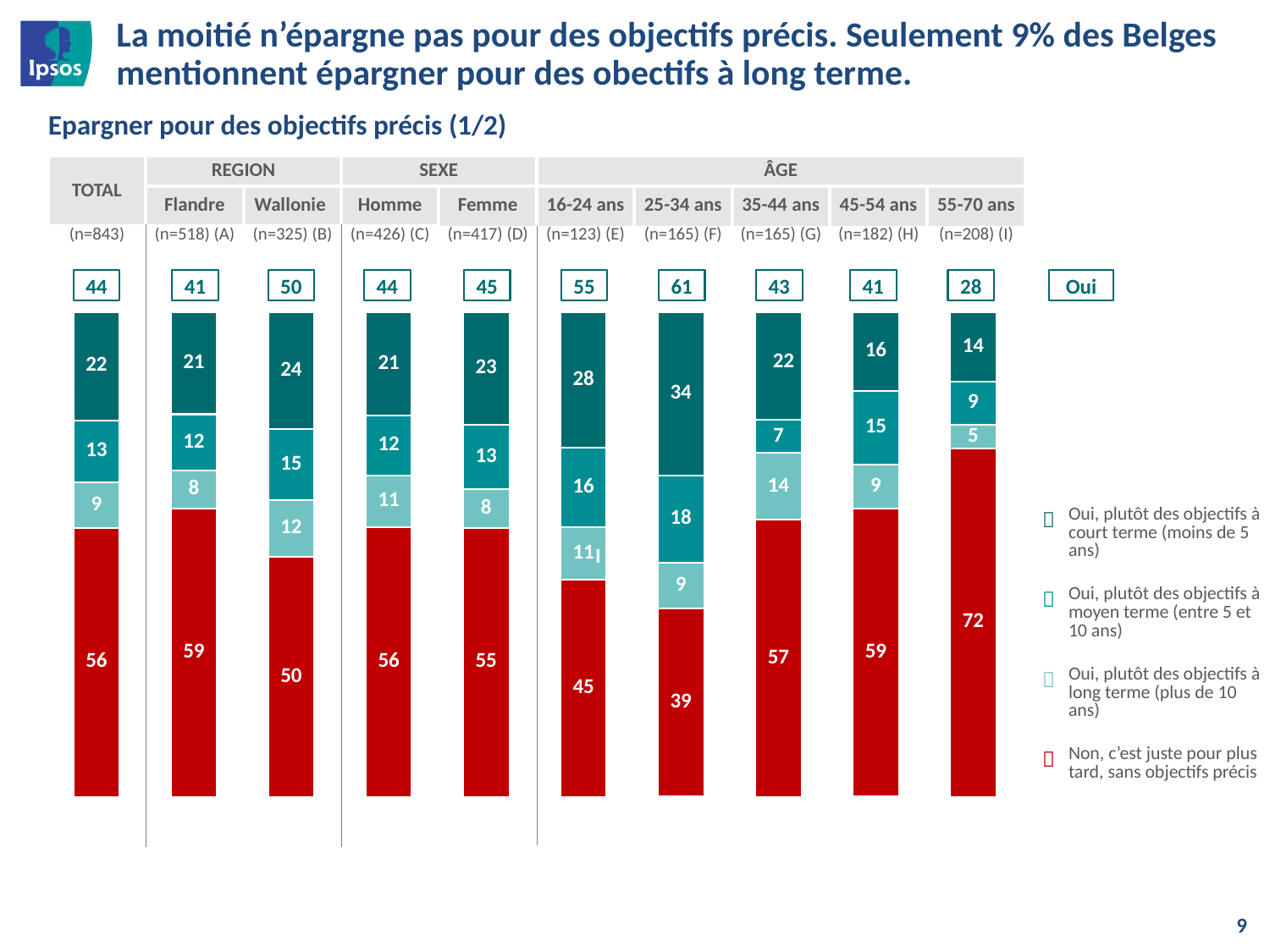
What kind of chart is shown on the slide? Stacked bar chart Which category has the lowest "Oui" value? 55-70 ans What is the "Oui" value shown above the bar for 25-34 ans? 61 What is the value of the "Oui, plutôt des objectifs à long terme (plus de 10 ans)" segment for Wallonie? 12 Which has a larger "Oui, plutôt des objectifs à court terme (moins de 5 ans)" value, Homme or Femme? Femme What is the value of the "Oui, plutôt des objectifs à moyen terme (entre 5 et 10 ans)" segment for 35-44 ans? 7 What is the sample size (n) shown for the 16-24 ans group? n=123 Which age group has the highest value for "Non, c'est juste pour plus tard, sans objectifs précis"? 55-70 ans What percentage of the TOTAL group answered "Non, c'est juste pour plus tard, sans objectifs précis"? 56 How many series does the legend list? 4 How many categories (bars) are shown in the chart? 10 What is the difference between the "Non" values for Flandre and Wallonie? 9